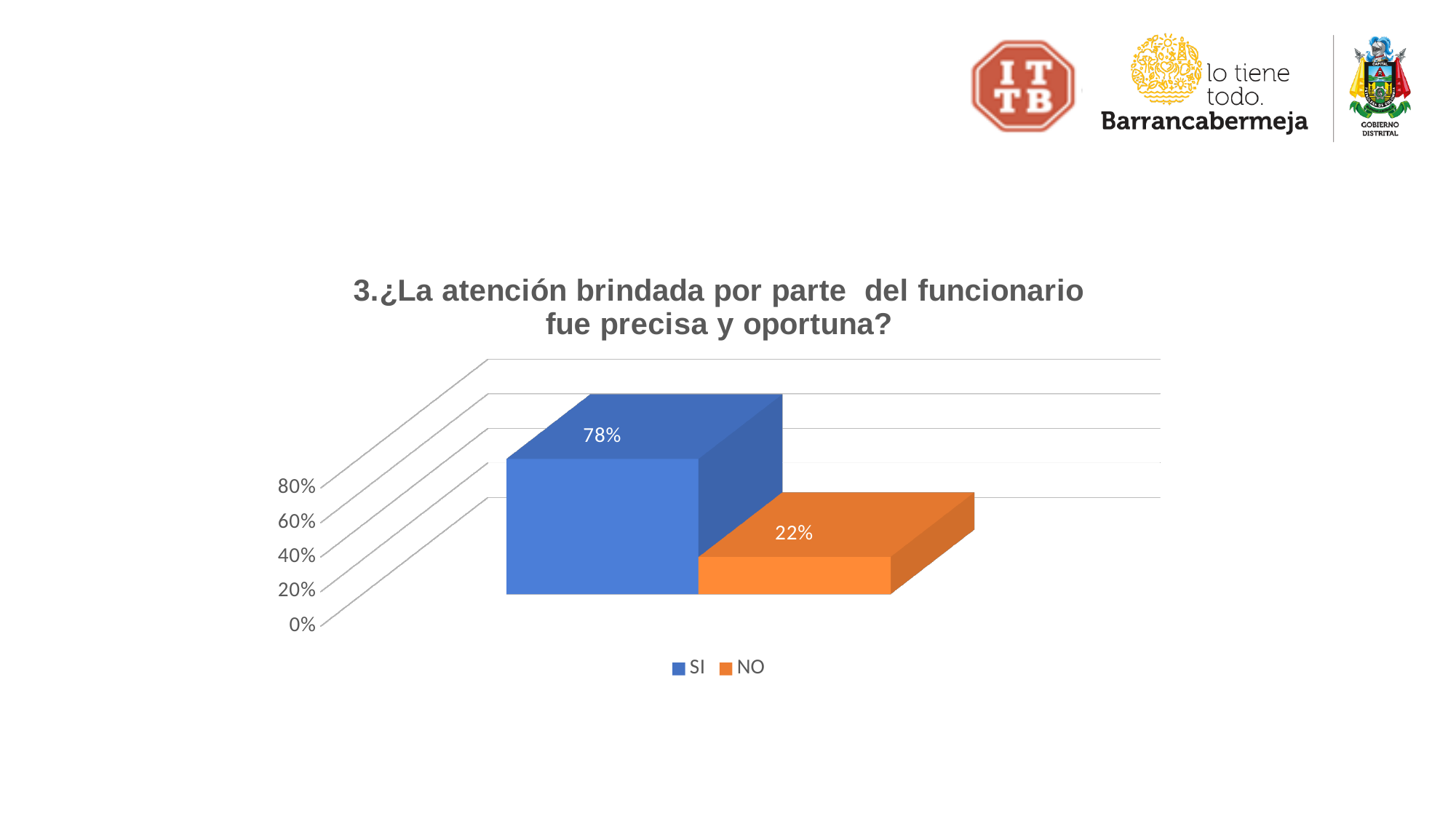
What is the value for SI? 78% What colour is the bar for NO? orange Which series has the lowest value? NO What is the difference between the SI and NO values? 56% What kind of chart is shown on the slide? bar chart Is the value for SI greater or less than 60%? greater What is the total of the SI and NO values? 100% Which is larger, the value for SI or the value for NO? SI Is the value for NO greater or less than 40%? less Which series has the highest value? SI How many series does the legend list? 2 What is the value for NO? 22%